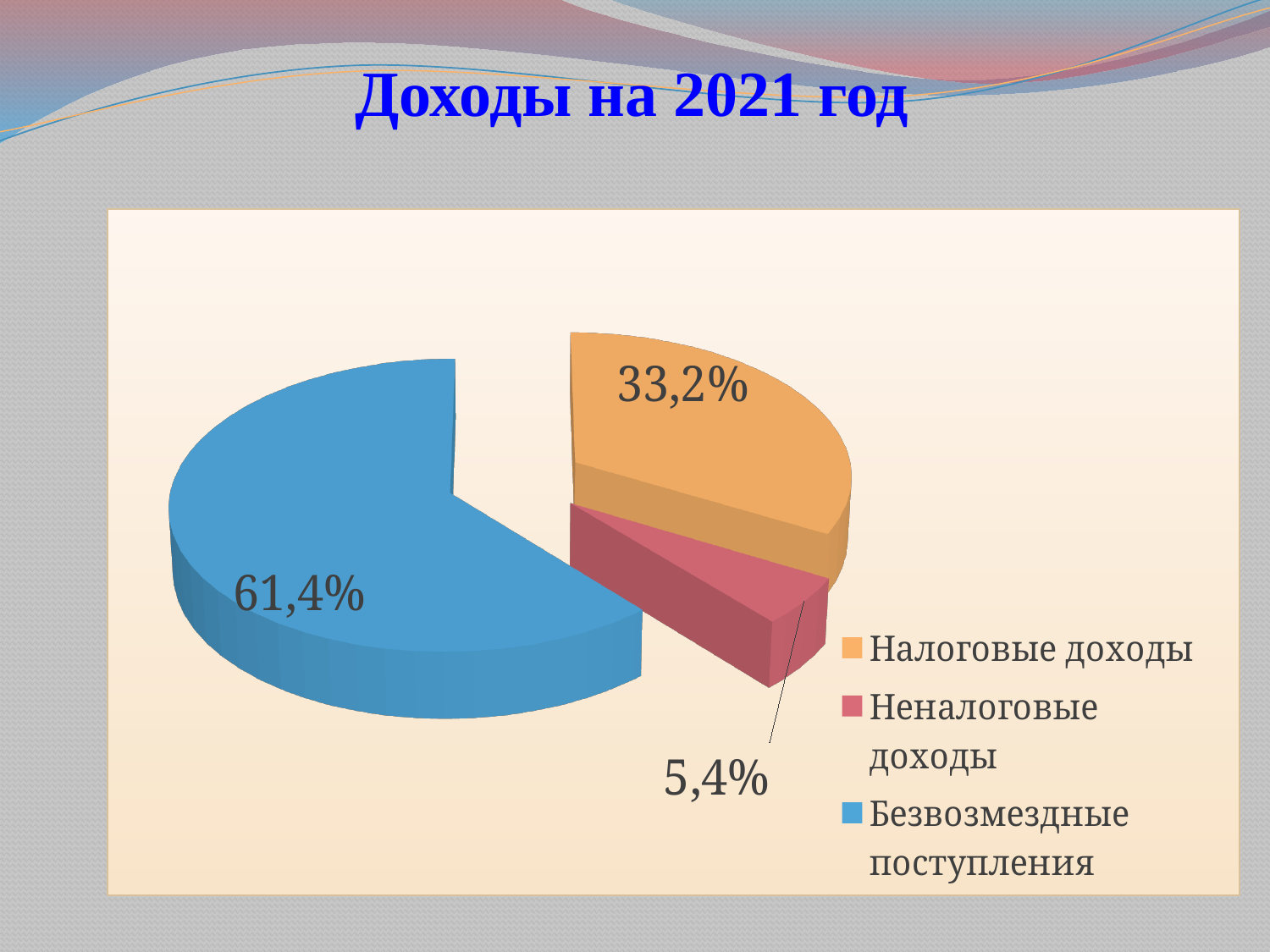
What is the value for Безвозмездные поступления? 61,4% What is the value for Неналоговые доходы? 5,4% What type of chart is shown on the slide? pie chart What is the difference between the shares of Безвозмездные поступления and Налоговые доходы? 28,2% What is the difference between the shares of Налоговые доходы and Неналоговые доходы? 27,8% What colour is the slice for Безвозмездные поступления? blue Which category has the smallest share of the pie? Неналоговые доходы What is the title of the slide? Доходы на 2021 год How many slices does the pie chart have? 3 What is the value for Налоговые доходы? 33,2% Which is larger: Налоговые доходы or Неналоговые доходы? Налоговые доходы Which category has the largest share of the pie? Безвозмездные поступления